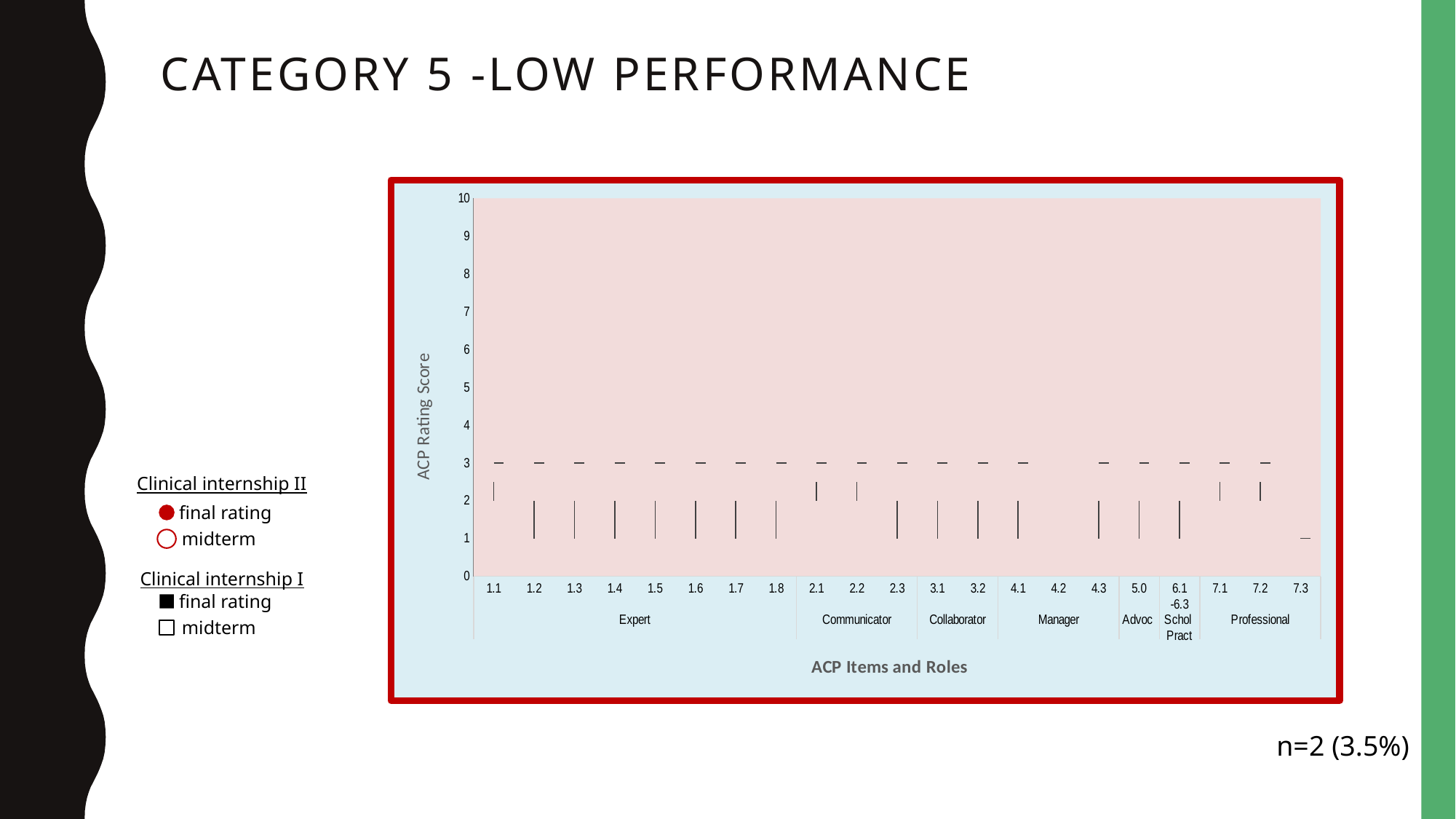
Is the highest plotted value for item 1.1 greater or less than 5? less Which role group on the horizontal axis contains items 2.1, 2.2 and 2.3? Communicator Is the highest plotted value for item 4.2 greater or less than 6? less What is the highest value shown on the vertical axis of the chart? 10 How many ACP items are listed under the Expert role on the horizontal axis? 8 How many role groups are labelled along the horizontal axis of the chart? 7 How many ACP items are labelled along the horizontal axis of the chart? 21 What is the title of the horizontal axis of the chart? ACP Items and Roles How many legend entries are listed beside the chart? 4 What is the title of the vertical axis of the chart? ACP Rating Score